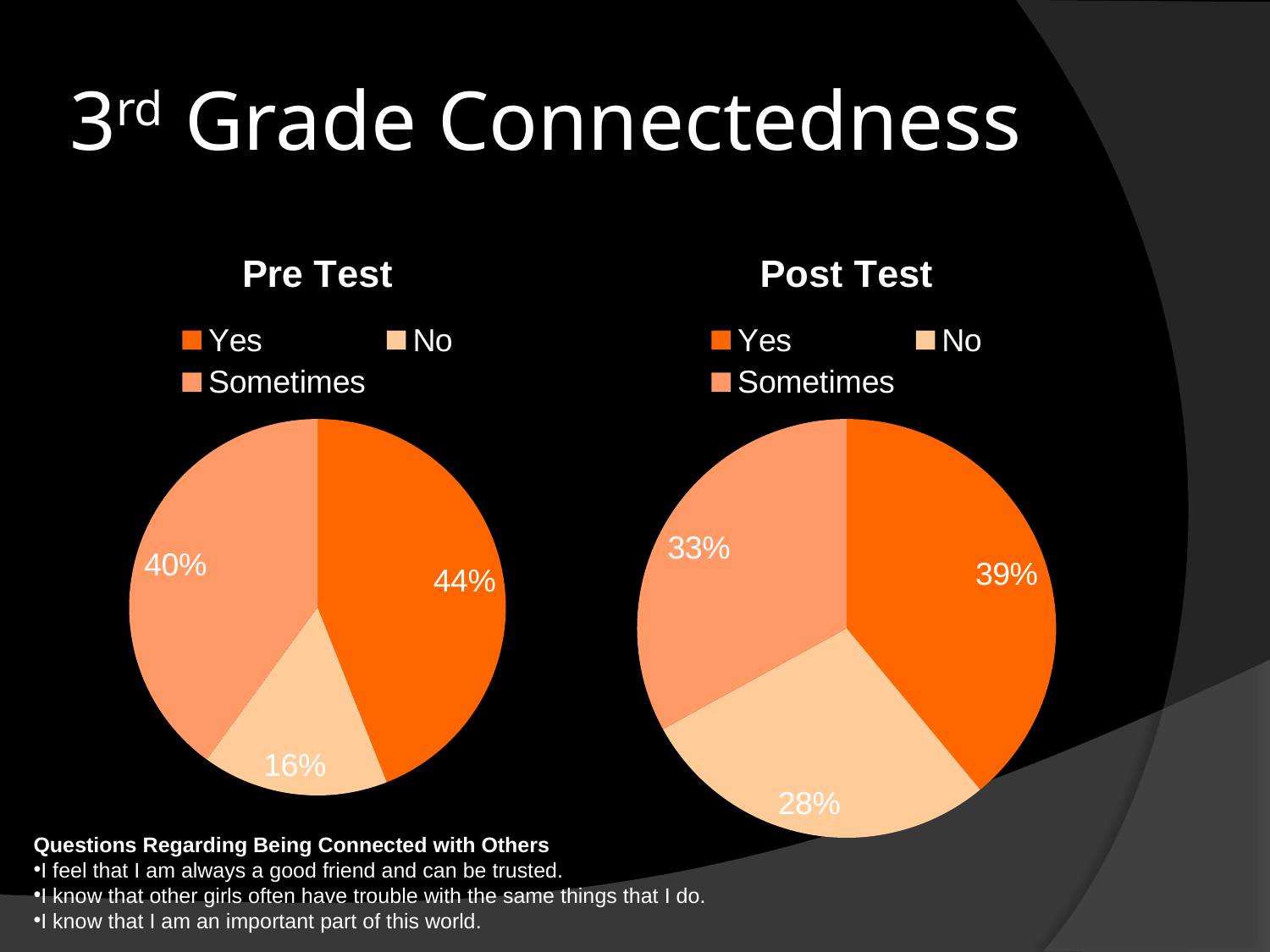
In the Post Test chart, which response has the largest slice? Yes What type of chart is used for the Post Test data? pie chart In the Post Test chart, what percentage of responses were "No"? 28% How much did the "No" percentage change from the Pre Test chart to the Post Test chart? 12% In the Pre Test chart, what is the difference between the "Yes" and "No" percentages? 28% What are the three legend entries in the Pre Test chart? Yes, No, Sometimes Is the "Yes" share larger in the Pre Test chart or the Post Test chart? Pre Test In the Pre Test chart, what percentage of responses were "Yes"? 44% In the Post Test chart, is the "No" slice larger or smaller than the "Sometimes" slice? smaller In the Post Test chart, what percentage of responses were "Sometimes"? 33% How many slices does the Pre Test pie chart have? 3 In the Pre Test chart, which response has the smallest slice? No